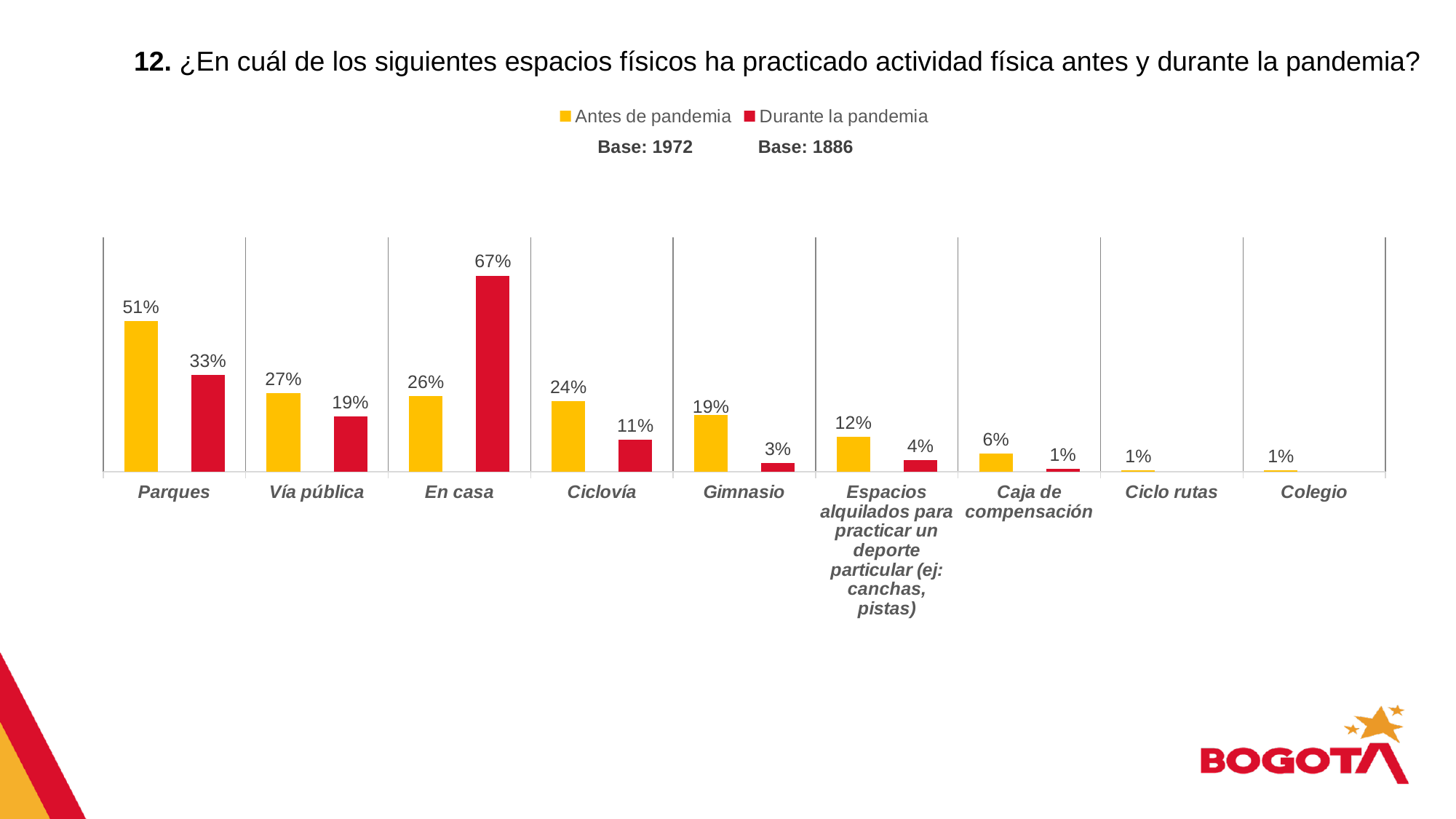
What is the value for Ciclovía in the Durante la pandemia series? 11% What is the value for Gimnasio in the Antes de pandemia series? 19% What is the difference between the Durante la pandemia and Antes de pandemia values for En casa? 41% What is the difference between the Antes de pandemia and Durante la pandemia values for Parques? 18% Which category has the highest value in the Durante la pandemia series? En casa What kind of chart is shown on the slide? Bar chart What is the value for En casa in the Durante la pandemia series? 67% How many series does the legend list? 2 Which is larger for Vía pública: the Antes de pandemia value or the Durante la pandemia value? Antes de pandemia How many categories are shown on the x axis? 9 What is the value for Parques in the Antes de pandemia series? 51% Which category has the highest value in the Antes de pandemia series? Parques